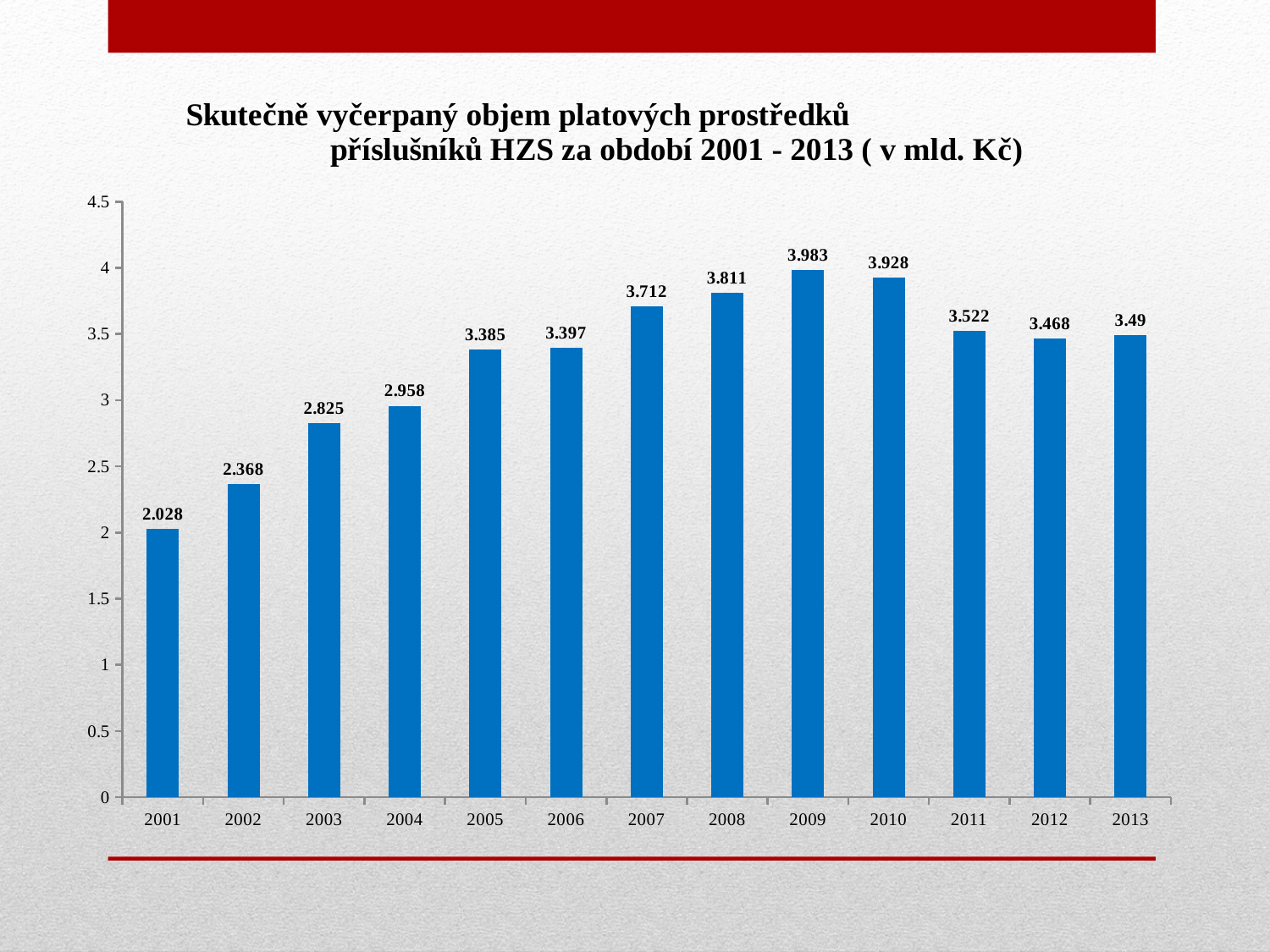
What is the value for 2009? 3.983 What is the difference between the values for 2009 and 2001? 1.955 Which is larger, the value for 2008 or the value for 2010? 2010 How many years are shown on the x axis? 13 What kind of chart is shown on the slide? bar chart What is the difference between the values for 2011 and 2012? 0.054 Which year has the lowest value? 2001 What is the value for 2001? 2.028 Is the value for 2004 greater or less than 3? less What is the value for 2013? 3.49 Which year has the highest value? 2009 Do the values rise or fall from 2001 to 2009? rise